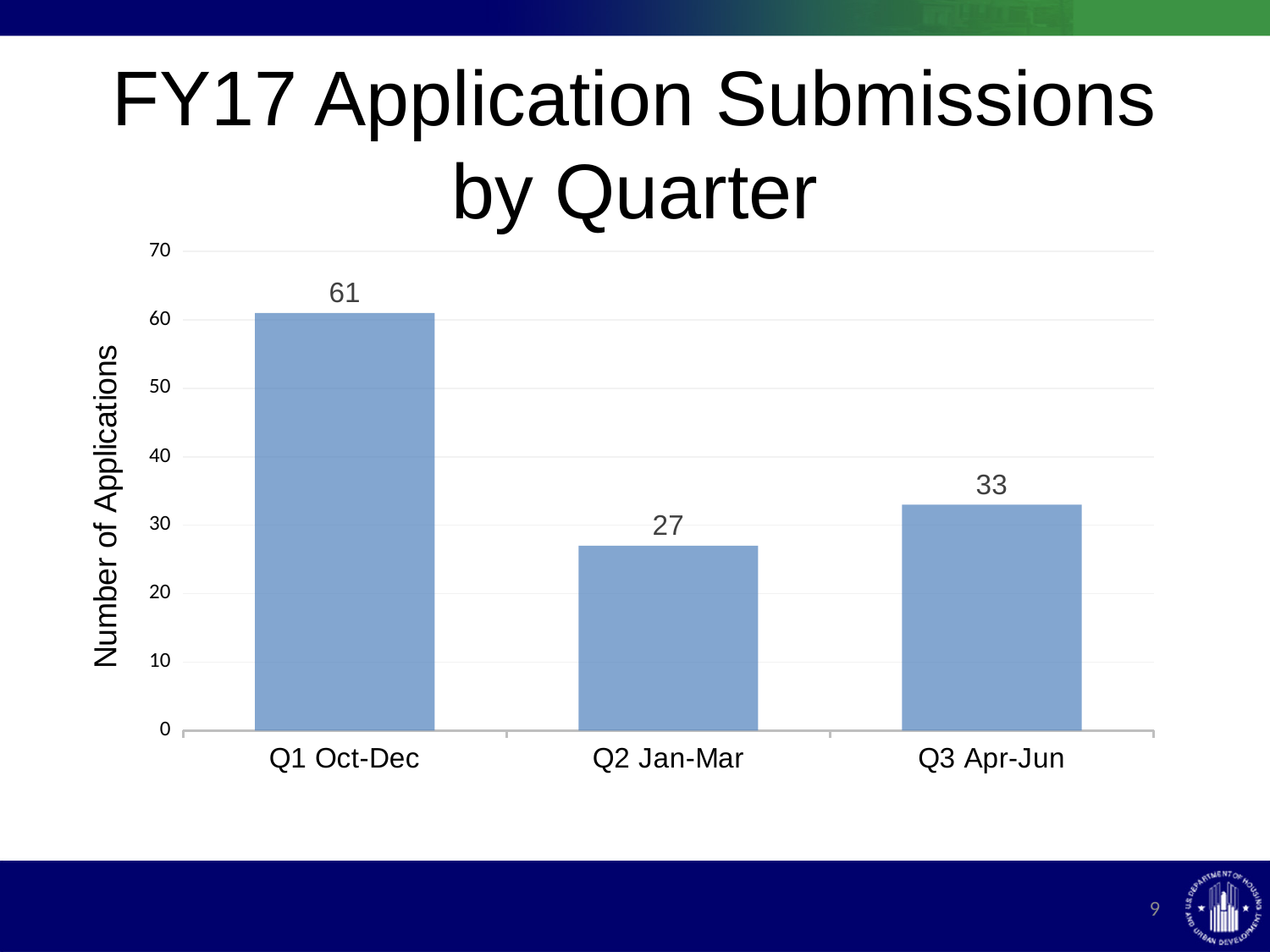
What is the difference in applications between Q3 Apr-Jun and Q2 Jan-Mar? 6 What type of chart is shown on the slide? Bar chart How many applications were submitted in Q3 Apr-Jun? 33 Is the value for Q1 Oct-Dec greater or less than 50? greater What is the difference in applications between Q1 Oct-Dec and Q2 Jan-Mar? 34 How many applications were submitted in Q1 Oct-Dec? 61 Which quarter had more applications, Q2 Jan-Mar or Q3 Apr-Jun? Q3 Apr-Jun How many applications were submitted in Q2 Jan-Mar? 27 Which quarter had the highest number of application submissions? Q1 Oct-Dec What is the label of the vertical axis? Number of Applications How many quarters are shown in the chart? 3 Which quarter had the lowest number of application submissions? Q2 Jan-Mar